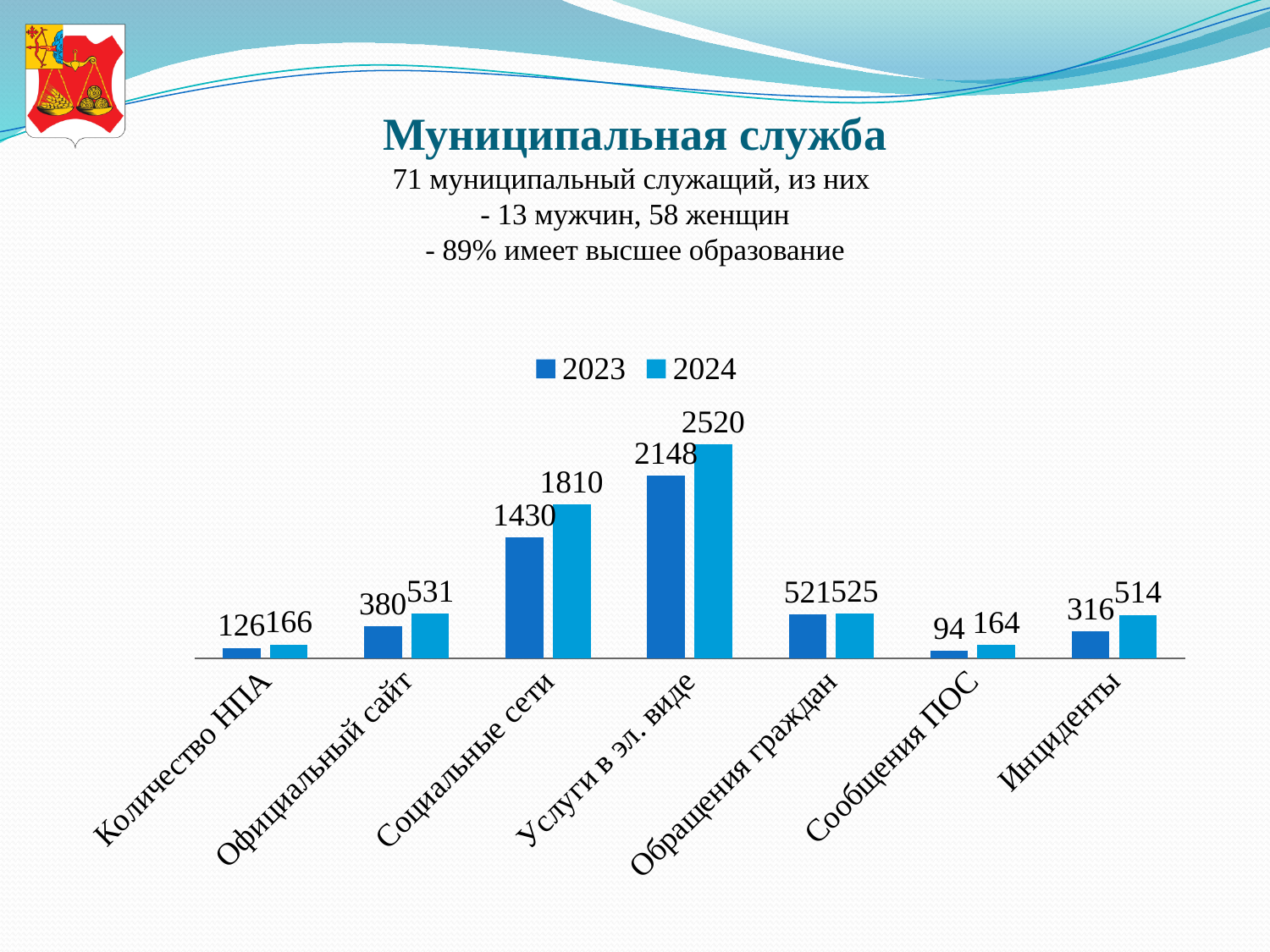
What is the value for Сообщения ПОС in 2023? 94 What kind of chart is shown on the slide? bar chart What is the value for Социальные сети in 2024? 1810 What is the difference between the 2024 and 2023 values for Услуги в эл. виде? 372 How many categories are shown on the x axis of the chart? 7 Which category has the highest value in the 2024 series? Услуги в эл. виде What are the two series named in the chart legend? 2023 and 2024 What is the difference between the 2024 and 2023 values for Официальный сайт? 151 Which is larger for Инциденты: the 2023 value or the 2024 value? 2024 How many series does the legend list? 2 Which category has the lowest value in the 2023 series? Сообщения ПОС What is the value for Инциденты in 2024? 514